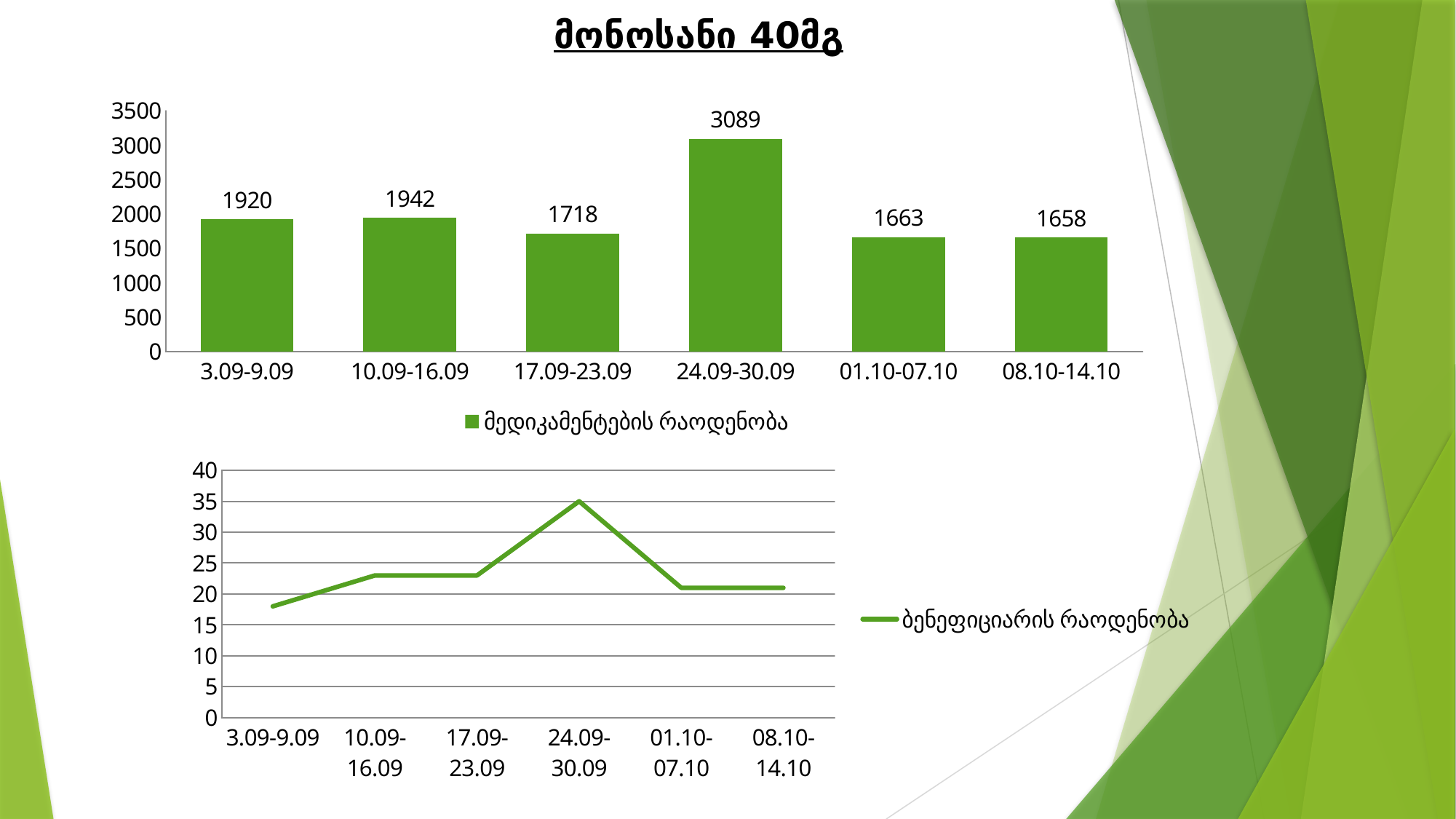
In the top bar chart, what is the value for 3.09-9.09? 1920 How many periods are shown on the x axis of the top bar chart? 6 In the top bar chart, which period has the lowest value? 08.10-14.10 In the top bar chart, what is the value for 08.10-14.10? 1658 In the bottom line chart, is the value for 24.09-30.09 greater or less than 30? greater What kind of chart is the bottom chart on the slide? line chart In the bottom line chart, which period has the highest value? 24.09-30.09 In the top bar chart, what is the difference between the values for 24.09-30.09 and 17.09-23.09? 1371 In the top bar chart, what is the value for 24.09-30.09? 3089 In the bottom line chart, is the value for 3.09-9.09 greater or less than 20? less In the top bar chart, which period has the highest value? 24.09-30.09 In the top bar chart, which is larger, the value for 10.09-16.09 or the value for 01.10-07.10? 10.09-16.09